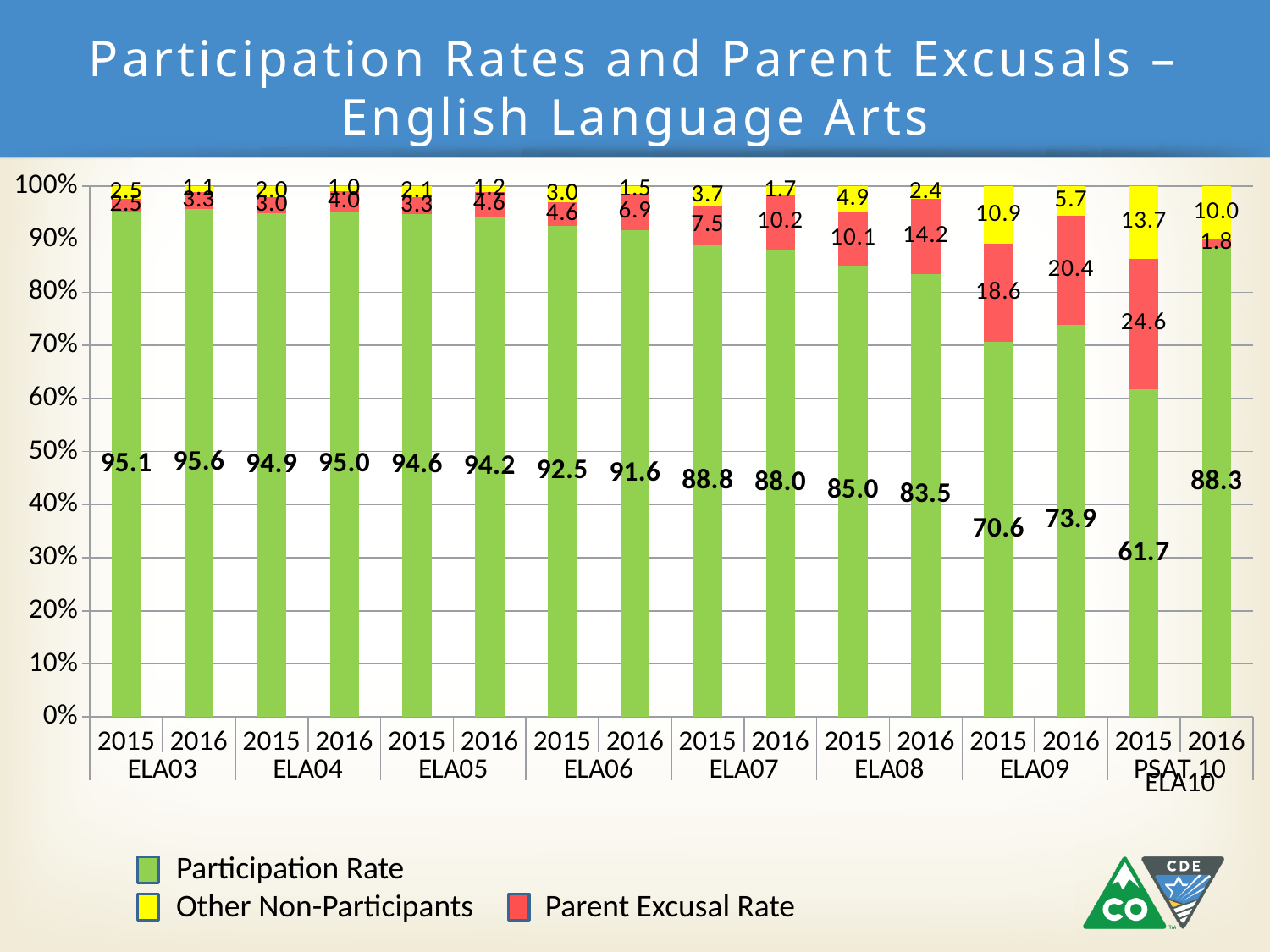
What is the Other Non-Participants value for 2016 ELA07? 1.7 What is the Participation Rate for 2016 ELA09? 73.9 Which bar has the highest Participation Rate? 2016 ELA03 What is the Parent Excusal Rate for 2015 ELA08? 10.1 Does the 2015 Participation Rate rise or fall from ELA03 to ELA09? Fall What is the difference in Parent Excusal Rate between 2016 ELA08 and 2015 ELA08? 4.1 What is the difference in Participation Rate between 2016 ELA09 and 2015 ELA09? 3.3 What is the Parent Excusal Rate for 2015 ELA09? 18.6 What kind of chart is shown on the slide? Stacked bar chart How many series does the legend list? 3 Is the Parent Excusal Rate for 2016 ELA06 larger or smaller than for 2016 ELA05? larger Which of the two ELA09 bars has the higher Parent Excusal Rate? 2016